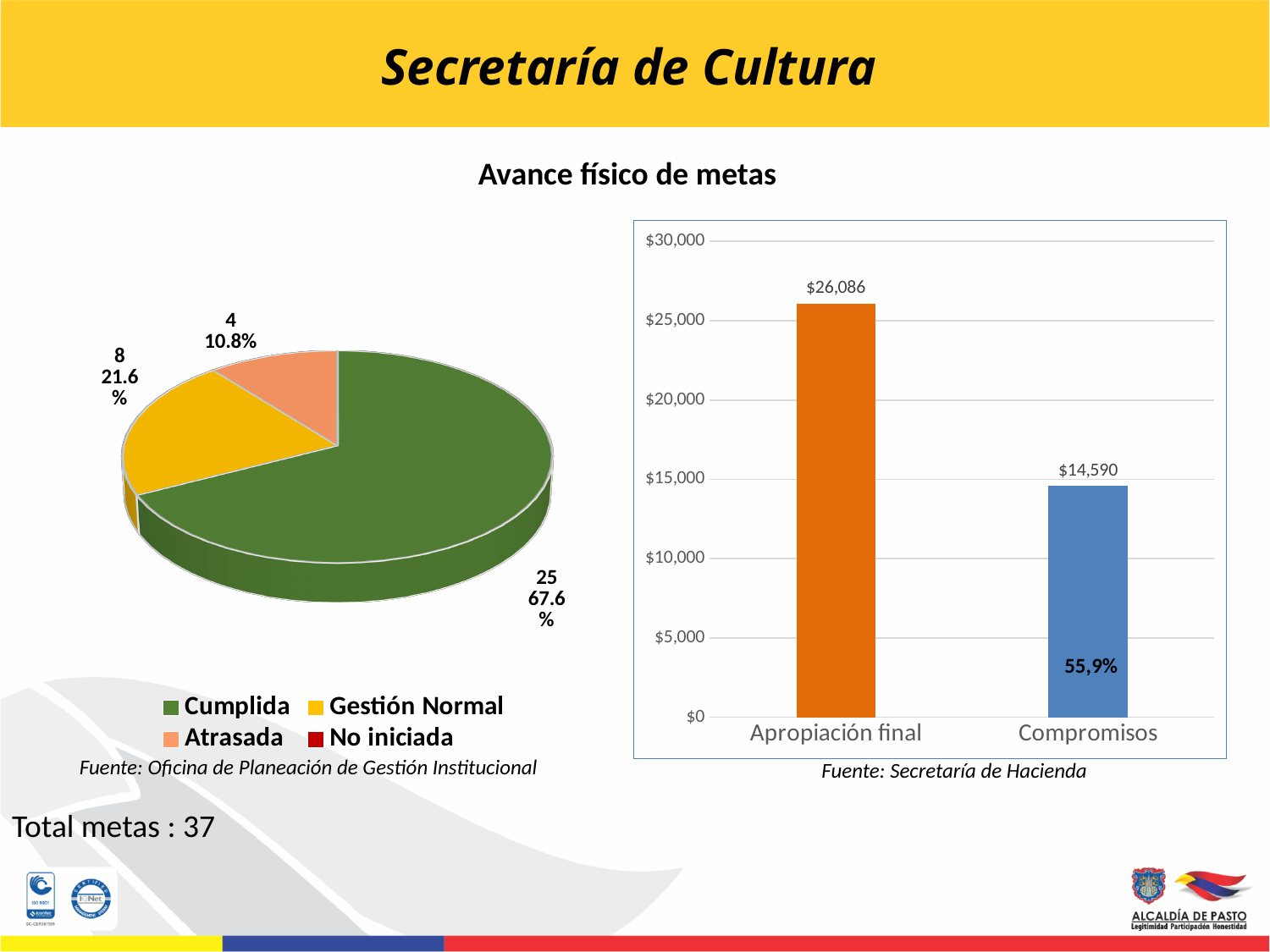
In the pie chart on the left, what percentage share does the Gestión Normal slice have? 21.6% In the pie chart on the left, which category has the largest slice? Cumplida What kind of chart is the chart on the right? Bar chart In the bar chart on the right, what is the difference between Apropiación final and Compromisos? $11,496 In the pie chart on the left, what percentage share does the Cumplida slice have? 67.6% In the pie chart on the left, how many metas are labelled Atrasada? 4 In the bar chart on the right, which category has the higher value, Apropiación final or Compromisos? Apropiación final In the pie chart on the left, what is the difference between the number of Cumplida metas and the number of Gestión Normal metas? 17 In the bar chart on the right, what is the value for Compromisos? $14,590 In the pie chart on the left, how many metas are labelled Cumplida? 25 In the pie chart on the left, how many entries does the legend list? 4 In the bar chart on the right, what is the value for Apropiación final? $26,086